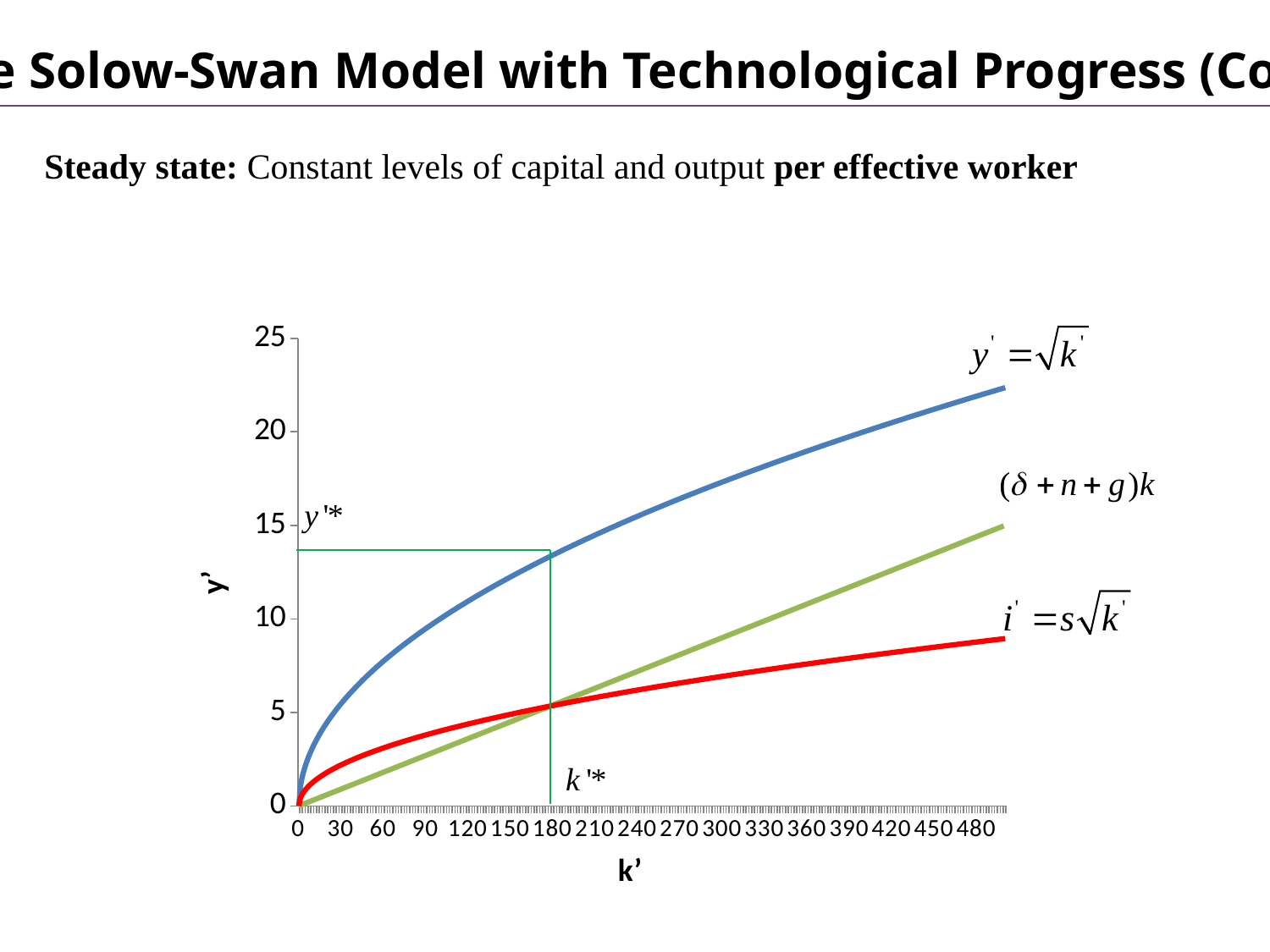
Does the curve y' = √k' rise or fall as k' increases? rises What is the label of the vertical axis? y' Which curve has the highest value at k' = 480? y' = √k' Is the value of the curve y' = √k' at k' = 480 greater or less than 20? greater At k' = 300, which is larger: the (δ+n+g)k line or the i' = s√k' curve? (δ+n+g)k What is the label of the horizontal axis? k' What kind of chart is shown on the slide? line chart Which curve has the lowest value at k' = 480? i' = s√k' How many curves are plotted on the chart? 3 At which value of k' on the horizontal axis is the steady state k'* marked by the vertical line? 180 At k' = 60, which is larger: the i' = s√k' curve or the (δ+n+g)k line? i' = s√k' Is the value of the curve i' = s√k' at k' = 480 greater or less than 10? less